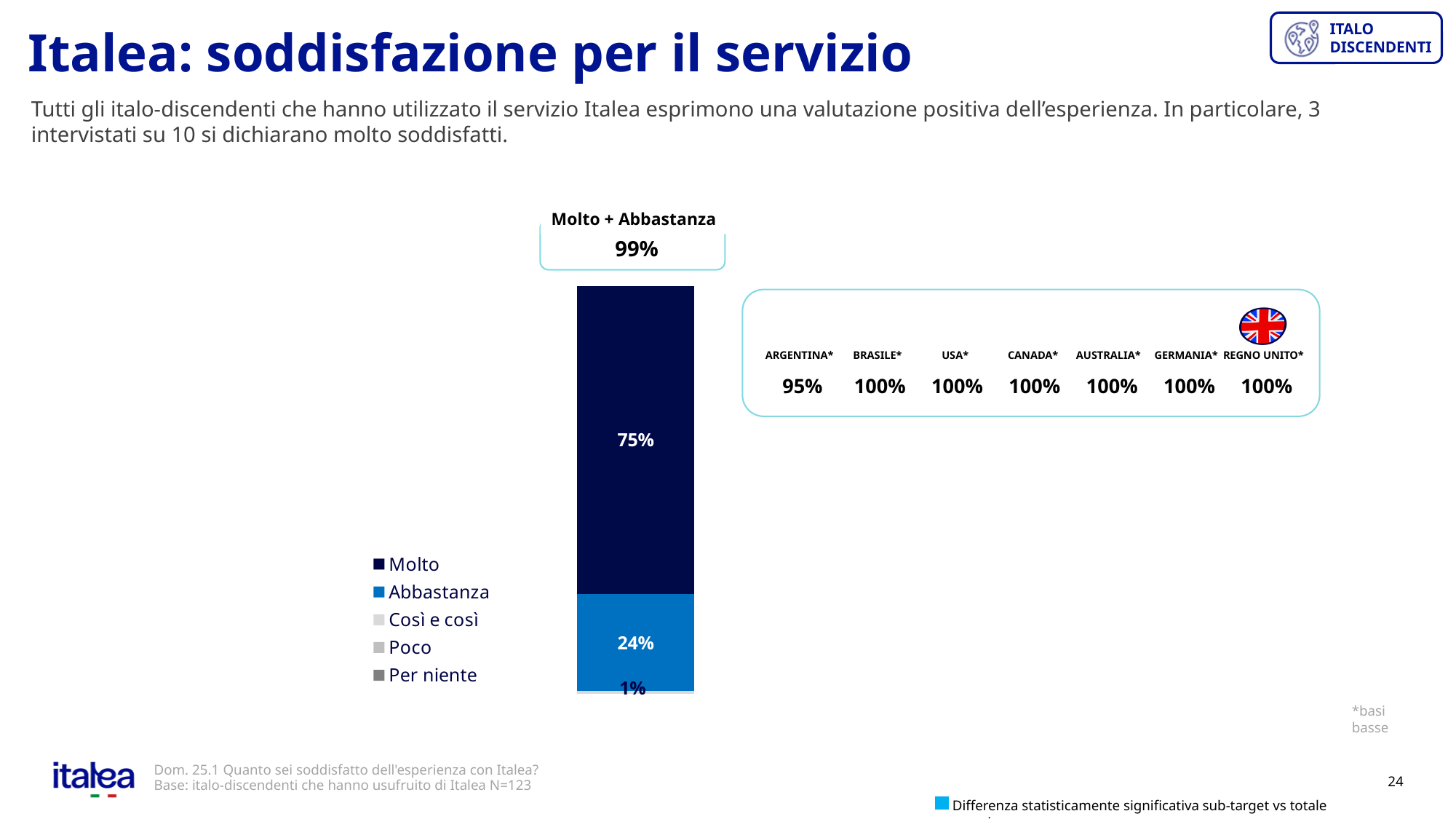
What is the combined value shown for "Molto + Abbastanza"? 99% What percentage of respondents answered "Molto" in the stacked bar? 75% What kind of chart is shown on the slide? Stacked bar chart What are the five entries in the chart legend? Molto, Abbastanza, Così e così, Poco, Per niente What percentage of respondents answered "Abbastanza" in the stacked bar? 24% How many series does the legend of the chart list? 5 How many countries are listed in the box next to the bar? 7 Which segment of the bar is larger, "Molto" or "Abbastanza"? Molto In the country box next to the bar, what is the value shown for Argentina? 95% What is the difference between the "Molto" and "Abbastanza" segments of the bar? 51% In the country box next to the bar, which country has the lowest value? Argentina Which response category has the largest segment in the stacked bar? Molto